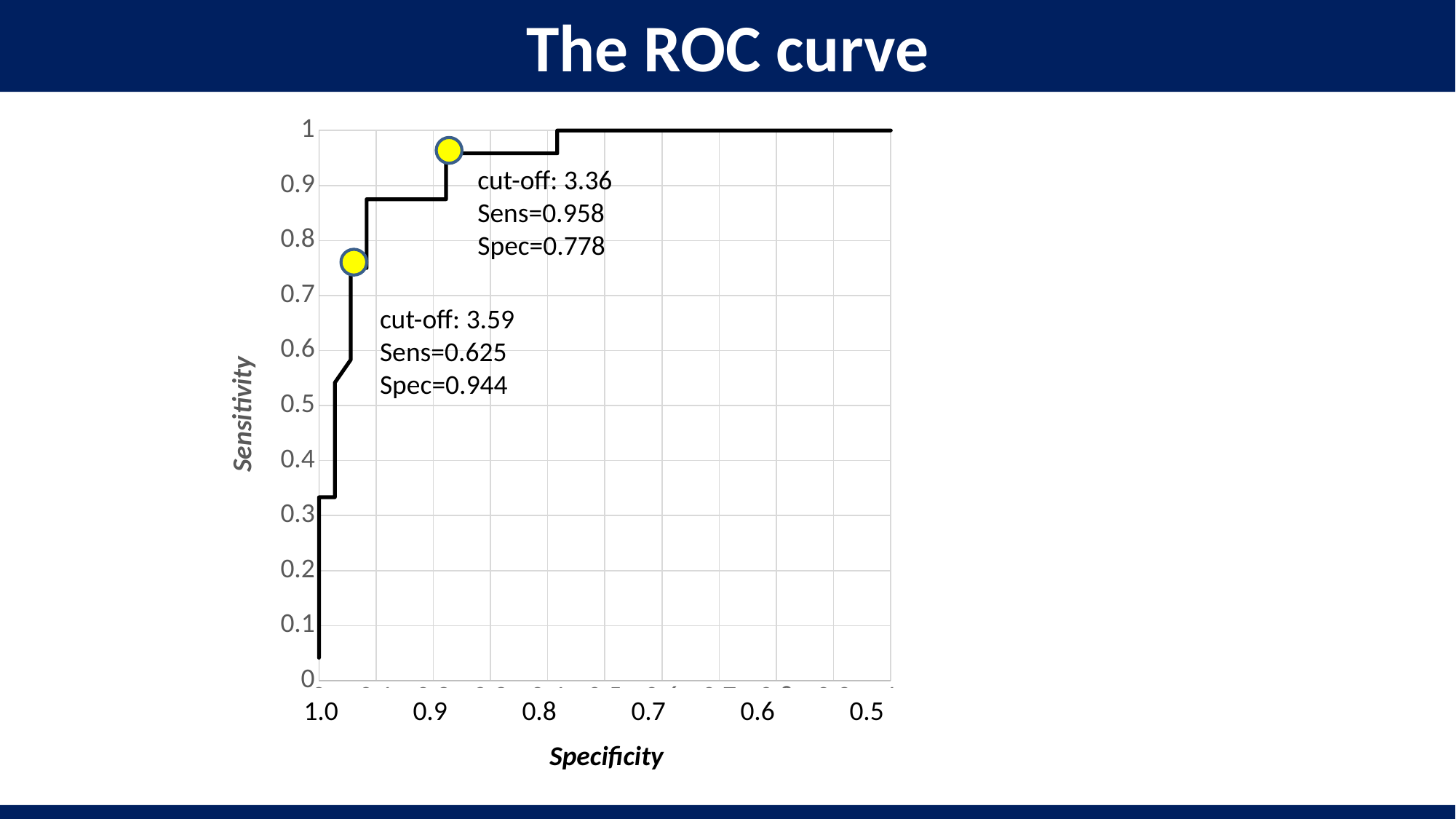
What is the specificity at the cut-off of 3.36? 0.778 What is the difference in specificity between the cut-off of 3.59 and the cut-off of 3.36? 0.166 What is the sensitivity at the cut-off of 3.59? 0.625 What is the difference in sensitivity between the cut-off of 3.36 and the cut-off of 3.59? 0.333 What is the label of the vertical axis? Sensitivity Which cut-off has the higher specificity, 3.36 or 3.59? 3.59 What kind of chart is shown on the slide? Line chart Which cut-off has the higher sensitivity, 3.36 or 3.59? 3.36 What is the specificity at the cut-off of 3.59? 0.944 As specificity decreases from 1.0 to 0.5 along the x axis, does sensitivity rise or fall? Rise What is the sensitivity at the cut-off of 3.36? 0.958 How many cut-off points are highlighted with yellow markers on the curve? 2